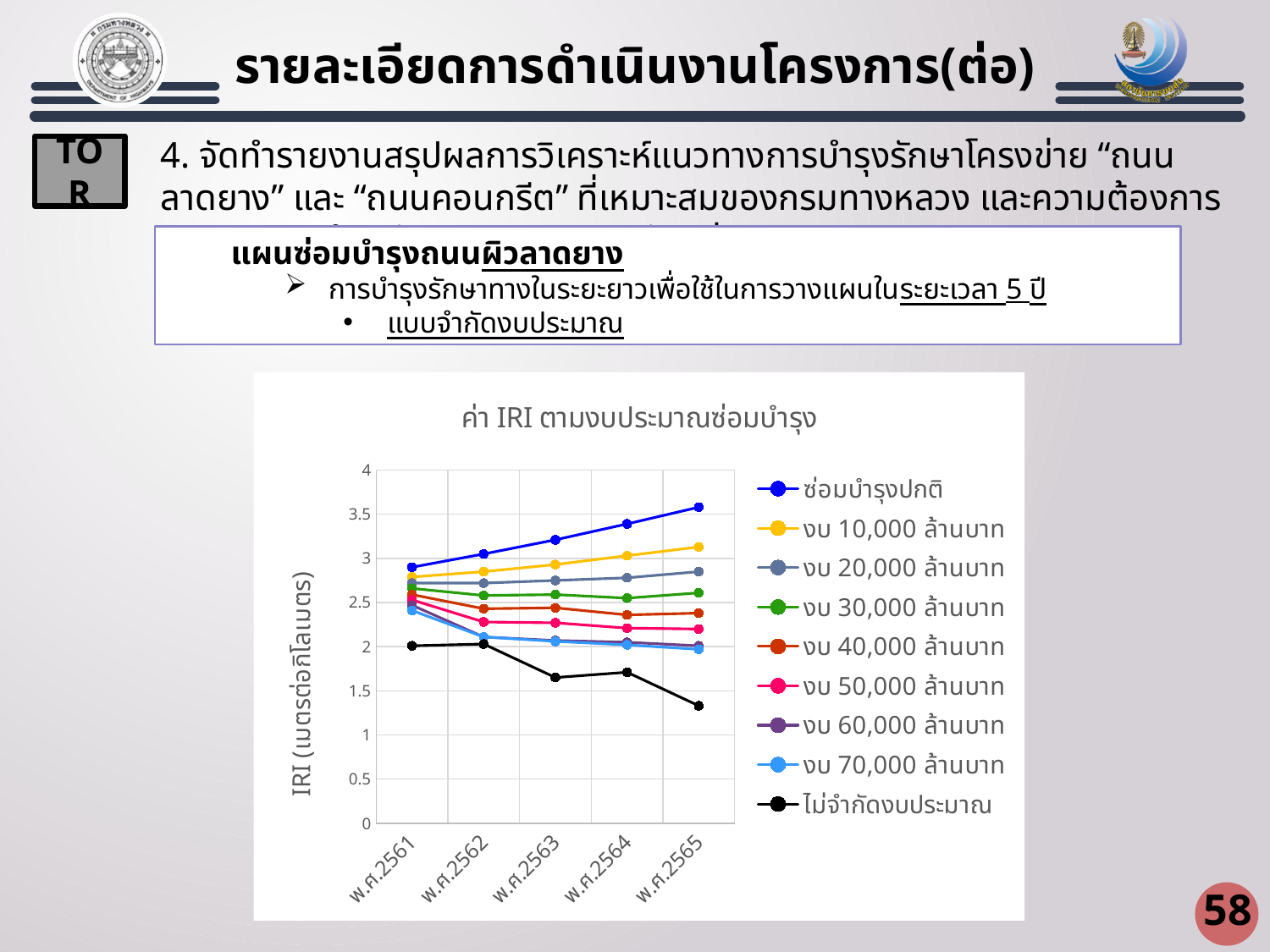
Does the ซ่อมบำรุงปกติ series rise or fall from พ.ศ.2561 to พ.ศ.2565? rise Which series has the lowest IRI value in พ.ศ.2565? ไม่จำกัดงบประมาณ Which series has the highest IRI value in พ.ศ.2565? ซ่อมบำรุงปกติ What is the title of the chart? ค่า IRI ตามงบประมาณซ่อมบำรุง What is the label of the vertical axis of the chart? IRI (เมตรต่อกิโลเมตร) In พ.ศ.2565, which is larger: the value for งบ 10,000 ล้านบาท or the value for งบ 70,000 ล้านบาท? งบ 10,000 ล้านบาท Is the value for ซ่อมบำรุงปกติ in พ.ศ.2565 greater or less than 3? greater What kind of chart is shown on the slide? line chart How many years are plotted along the x axis of the chart? 5 Is the value for ไม่จำกัดงบประมาณ in พ.ศ.2565 greater or less than 1.5? less Does the ไม่จำกัดงบประมาณ series rise or fall overall from พ.ศ.2561 to พ.ศ.2565? fall How many series does the legend of the chart list? 9